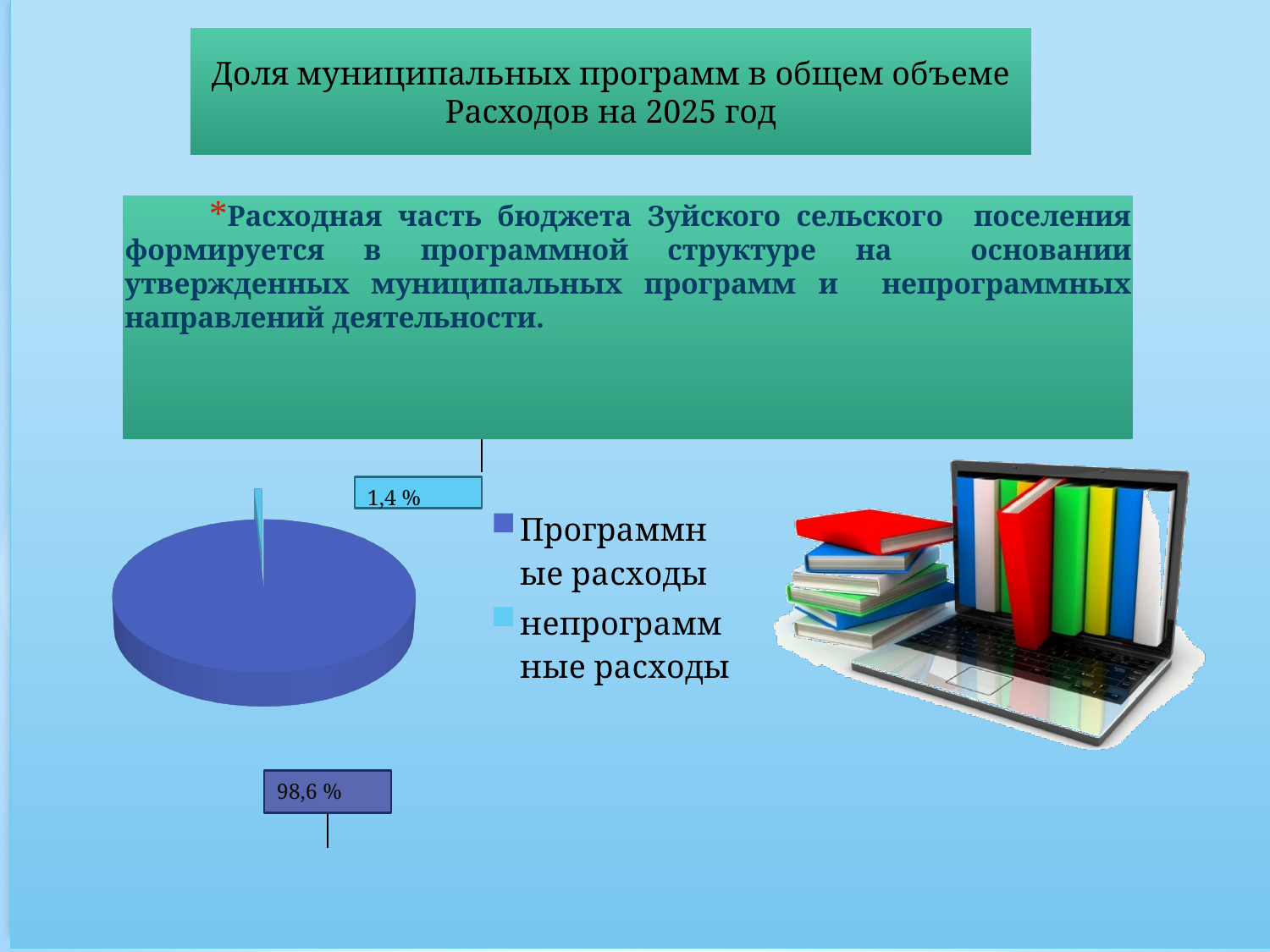
What share of the pie is labelled for непрограммные расходы? 1,4 % Which category has the largest slice of the pie? Программные расходы What share of the pie is labelled for Программные расходы? 98,6 % What colour is the slice for непрограммные расходы in the legend? light blue Which is larger: Программные расходы or непрограммные расходы? Программные расходы Which category has the smallest slice of the pie? непрограммные расходы How many slices does the pie chart have? 2 What is the difference in percentage points between Программные расходы and непрограммные расходы? 97,2 % What kind of chart is shown on the slide? pie chart What is the title shown above the chart on the slide? Доля муниципальных программ в общем объеме Расходов на 2025 год How many entries does the legend list? 2